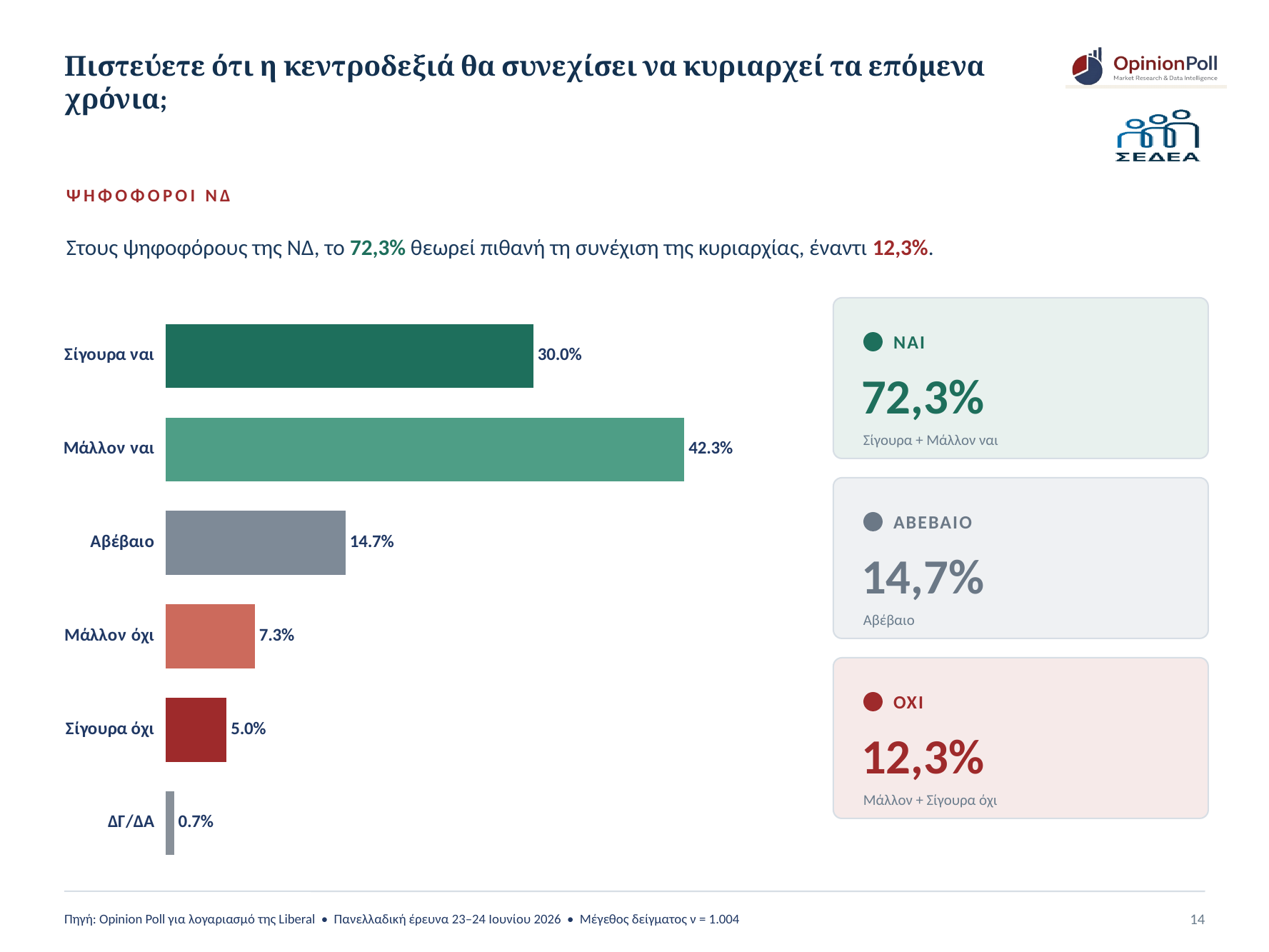
What colour is the bar for Σίγουρα όχι? Dark red What is the value for Αβέβαιο? 14.7% What is the value for Σίγουρα ναι? 30.0% Which category has the highest value? Μάλλον ναι How many categories are shown in the bar chart? 6 What is the value for Σίγουρα όχι? 5.0% Which is larger, Μάλλον όχι or Σίγουρα όχι? Μάλλον όχι Which category has the lowest value? ΔΓ/ΔΑ What kind of chart is shown on the slide? Bar chart What is the combined value of Μάλλον όχι and Σίγουρα όχι? 12.3% What is the value for Μάλλον ναι? 42.3% What is the difference between Μάλλον ναι and Σίγουρα ναι? 12.3%